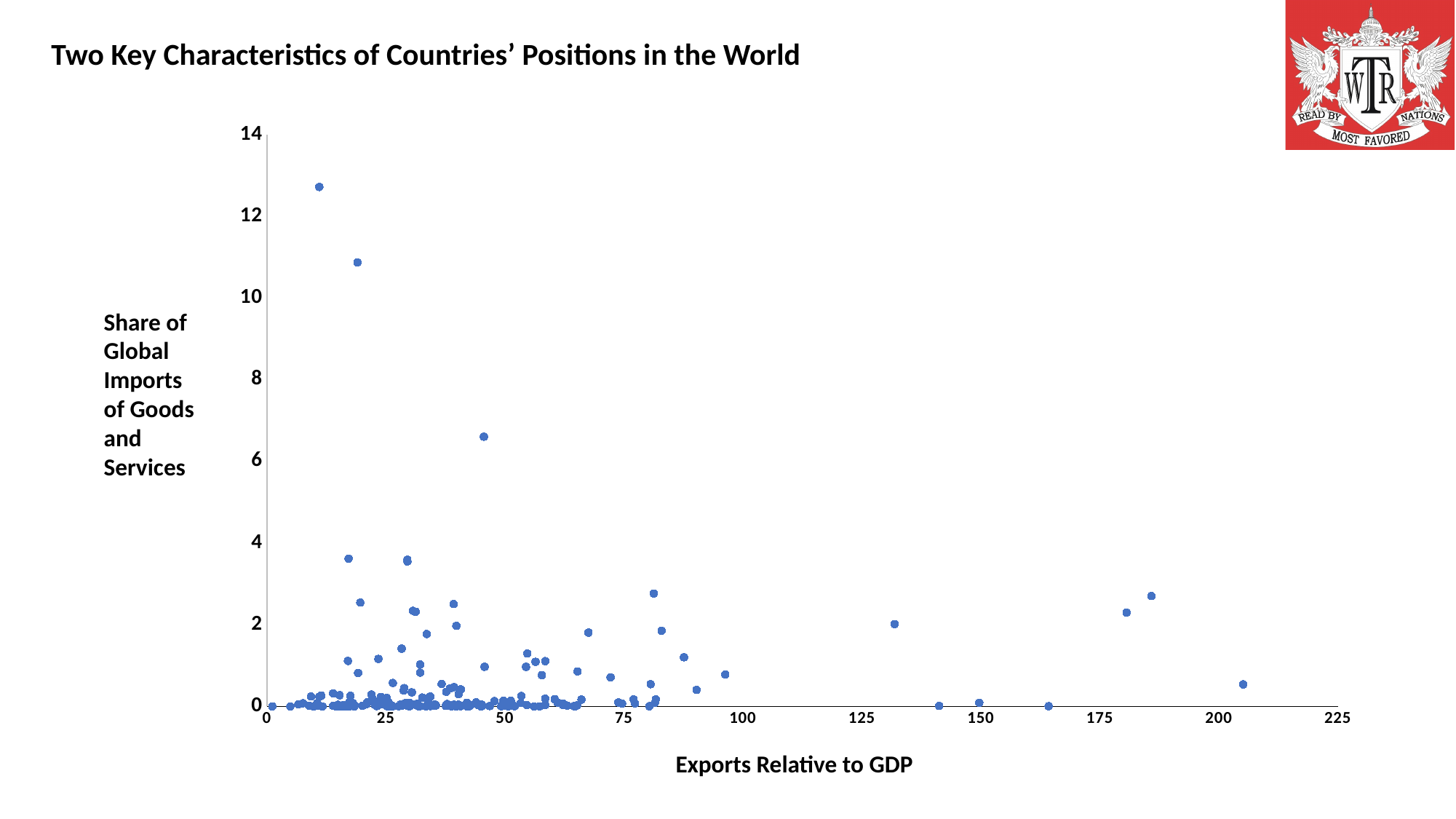
Is the point near x = 46 with the highest y value greater or less than 6 on the y axis? greater What is the maximum value shown on the y axis? 14 Is the point near x = 132 greater or less than 4 on the y axis? less Is the highest point on the chart greater or less than 12 on the y axis? greater What is the title of the chart on the slide? Two Key Characteristics of Countries' Positions in the World What kind of chart is shown on the slide? scatter chart Which has the larger y value: the highest point near x = 10 or the highest point near x = 46? the point near x = 10 What is the label of the x axis? Exports Relative to GDP